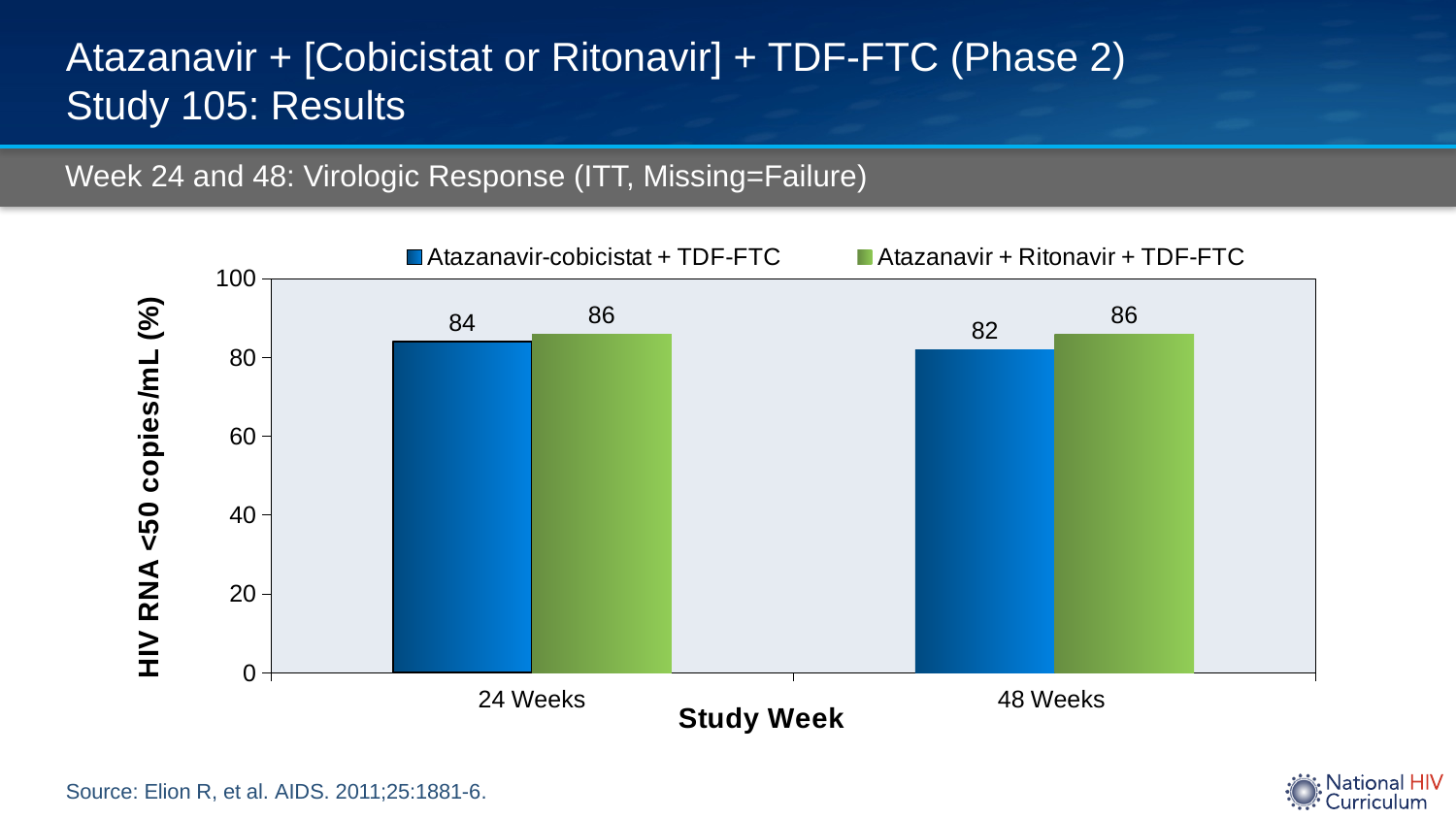
How many study week categories are shown on the x axis? 2 What is the difference between the two series at 24 Weeks? 2 How many series does the legend list? 2 What is the value for Atazanavir + Ritonavir + TDF-FTC at 48 Weeks? 86 What kind of chart is shown on the slide? Bar chart What is the label of the y axis? HIV RNA <50 copies/mL (%) What is the difference between the two series at 48 Weeks? 4 Which series has the higher value at 48 Weeks? Atazanavir + Ritonavir + TDF-FTC Does the value for Atazanavir-cobicistat + TDF-FTC rise or fall from 24 Weeks to 48 Weeks? Fall Which bar has the lowest value on the chart? Atazanavir-cobicistat + TDF-FTC at 48 Weeks What is the value for Atazanavir-cobicistat + TDF-FTC at 48 Weeks? 82 What is the value for Atazanavir-cobicistat + TDF-FTC at 24 Weeks? 84